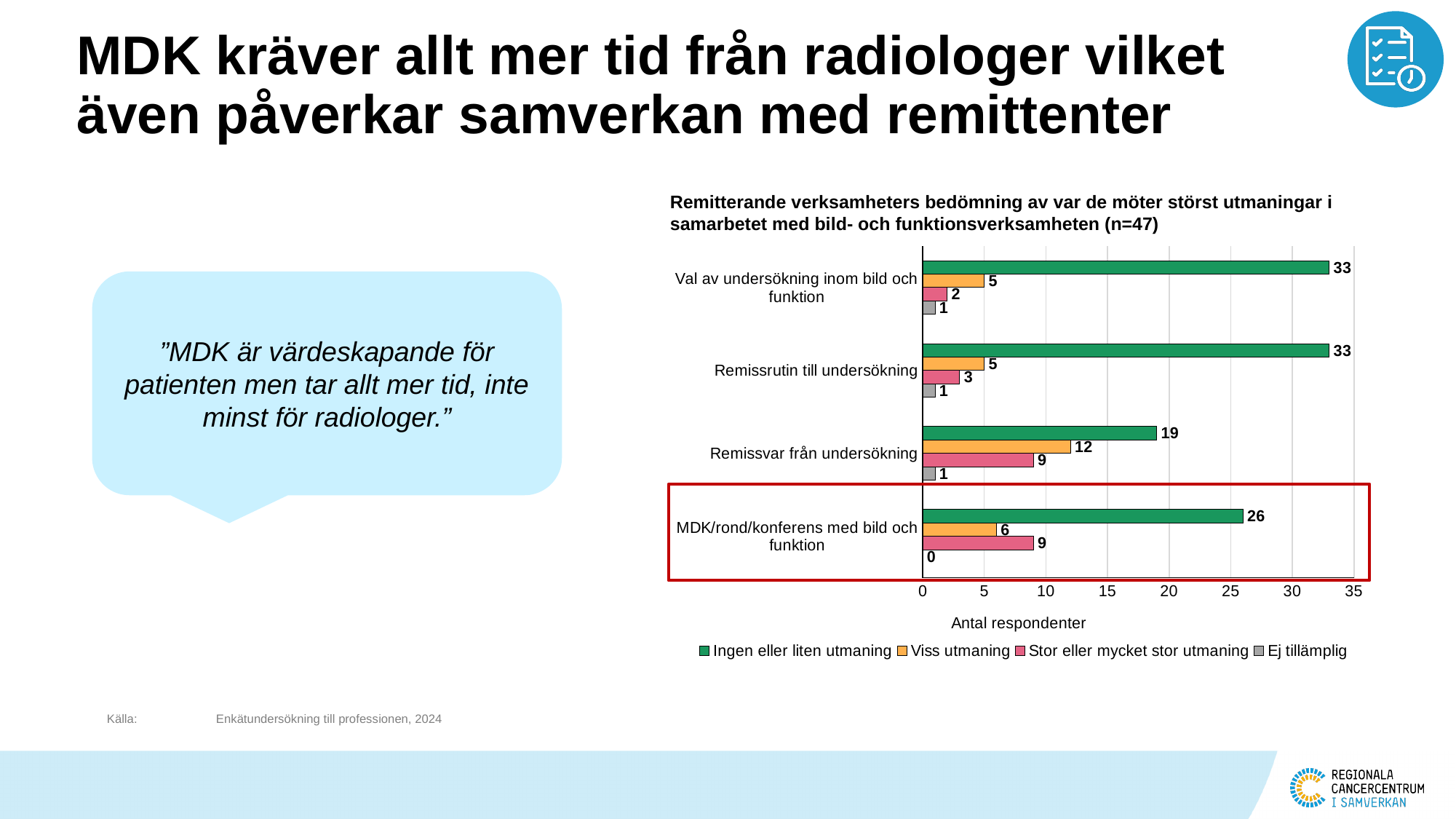
What is the value of 'Stor eller mycket stor utmaning' for 'Remissrutin till undersökning'? 3 What is the value of 'Viss utmaning' for 'Remissvar från undersökning'? 12 How many series does the legend list? 4 What is the value of 'Ingen eller liten utmaning' for 'MDK/rond/konferens med bild och funktion'? 26 What type of chart is shown on the slide? bar chart Which category has the highest value for 'Viss utmaning'? Remissvar från undersökning What is the x-axis title of the chart? Antal respondenter What is the value of 'Ej tillämplig' for 'MDK/rond/konferens med bild och funktion'? 0 What is the difference between 'Ingen eller liten utmaning' for 'Val av undersökning inom bild och funktion' and for 'MDK/rond/konferens med bild och funktion'? 7 How many categories are shown on the chart? 4 Which category has the lowest value for 'Ingen eller liten utmaning'? Remissvar från undersökning Which is larger: 'Stor eller mycket stor utmaning' for 'MDK/rond/konferens med bild och funktion' or for 'Val av undersökning inom bild och funktion'? MDK/rond/konferens med bild och funktion